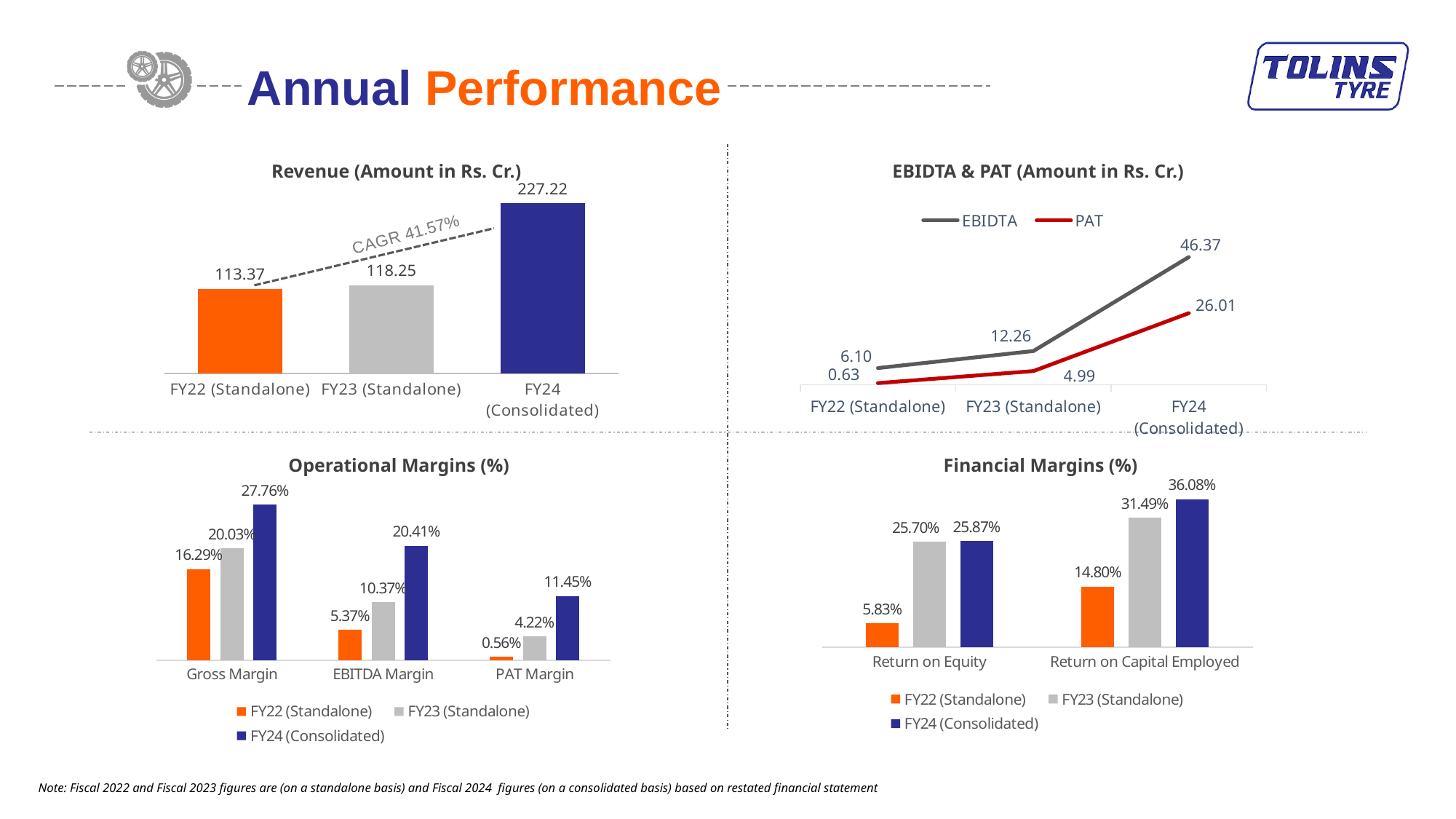
In the Revenue chart, what is the revenue for FY24 (Consolidated)? 227.22 In the Operational Margins chart, which category has the lowest FY22 (Standalone) value? PAT Margin In the Financial Margins chart, what is the Return on Capital Employed for FY23 (Standalone)? 31.49% In the Operational Margins chart, what is the EBITDA Margin for FY24 (Consolidated)? 20.41% What kind of chart is the EBIDTA & PAT chart? Line chart In the Revenue chart, what CAGR is shown? 41.57% In the Revenue chart, which fiscal year has the lowest revenue? FY22 (Standalone) In the EBIDTA & PAT chart, do EBIDTA values rise or fall from FY22 to FY24? Rise In the Revenue chart, what is the difference between FY24 (Consolidated) and FY23 (Standalone) revenue? 108.97 In the EBIDTA & PAT chart, what is the EBIDTA value for FY24 (Consolidated)? 46.37 In the EBIDTA & PAT chart, what is the PAT value for FY23 (Standalone)? 4.99 In the EBIDTA & PAT chart, how many series does the legend list? 2